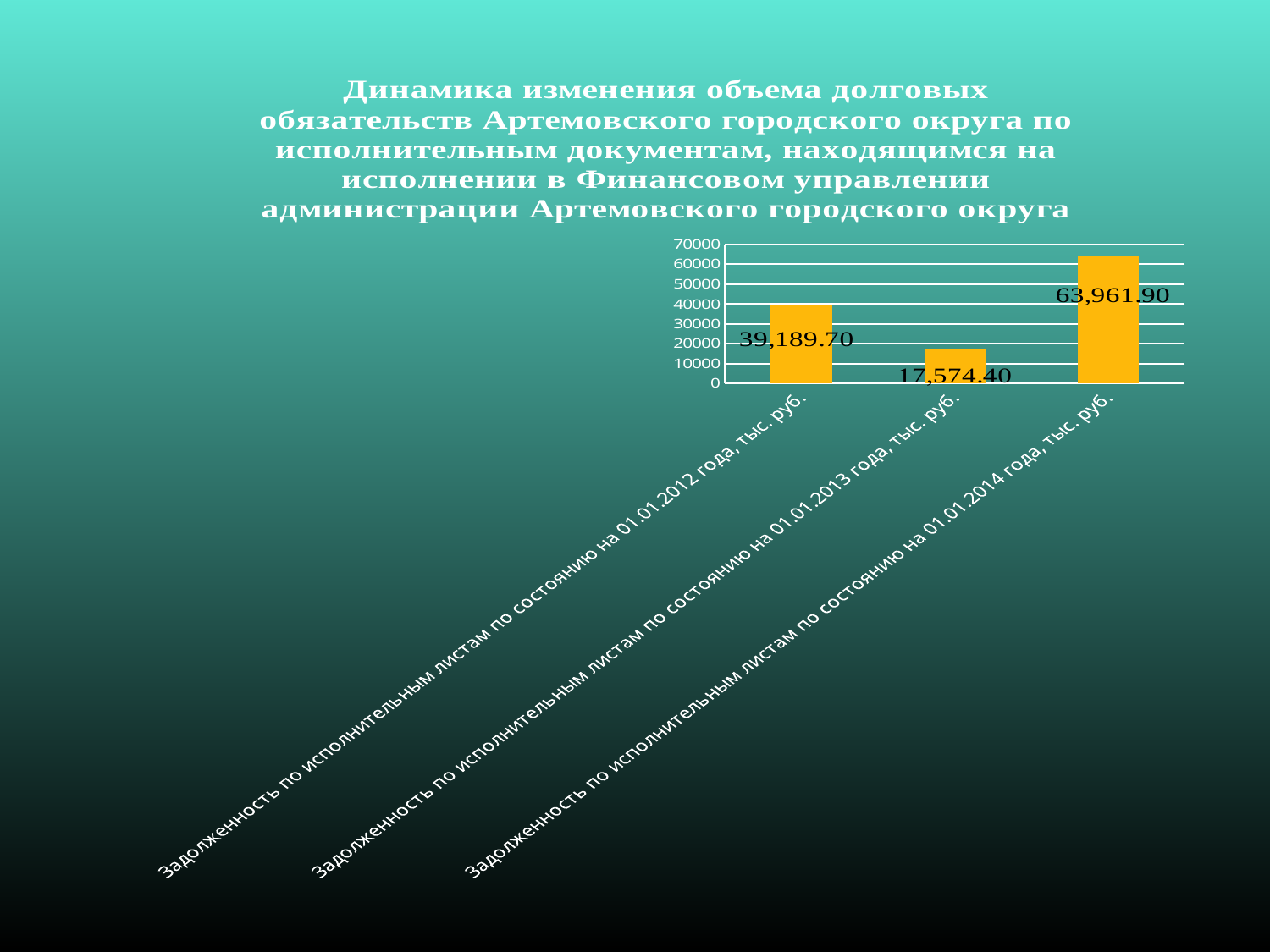
What kind of chart is shown on the slide? Bar chart How many bars are shown in the chart? 3 Which date has the highest debt value? 01.01.2014 What is the maximum value shown on the vertical axis? 70000 What is the value of the debt on executive documents as of 01.01.2012 (тыс. руб.)? 39,189.70 What is the value of the debt on executive documents as of 01.01.2013 (тыс. руб.)? 17,574.40 Which date has the lowest debt value? 01.01.2013 Which is larger: the debt as of 01.01.2012 or as of 01.01.2013? 01.01.2012 What is the value of the debt on executive documents as of 01.01.2014 (тыс. руб.)? 63,961.90 Is the value for 01.01.2014 greater or less than 60000? greater What is the difference between the debt as of 01.01.2012 and as of 01.01.2013? 21,615.30 What is the difference between the debt as of 01.01.2014 and as of 01.01.2012? 24,772.20